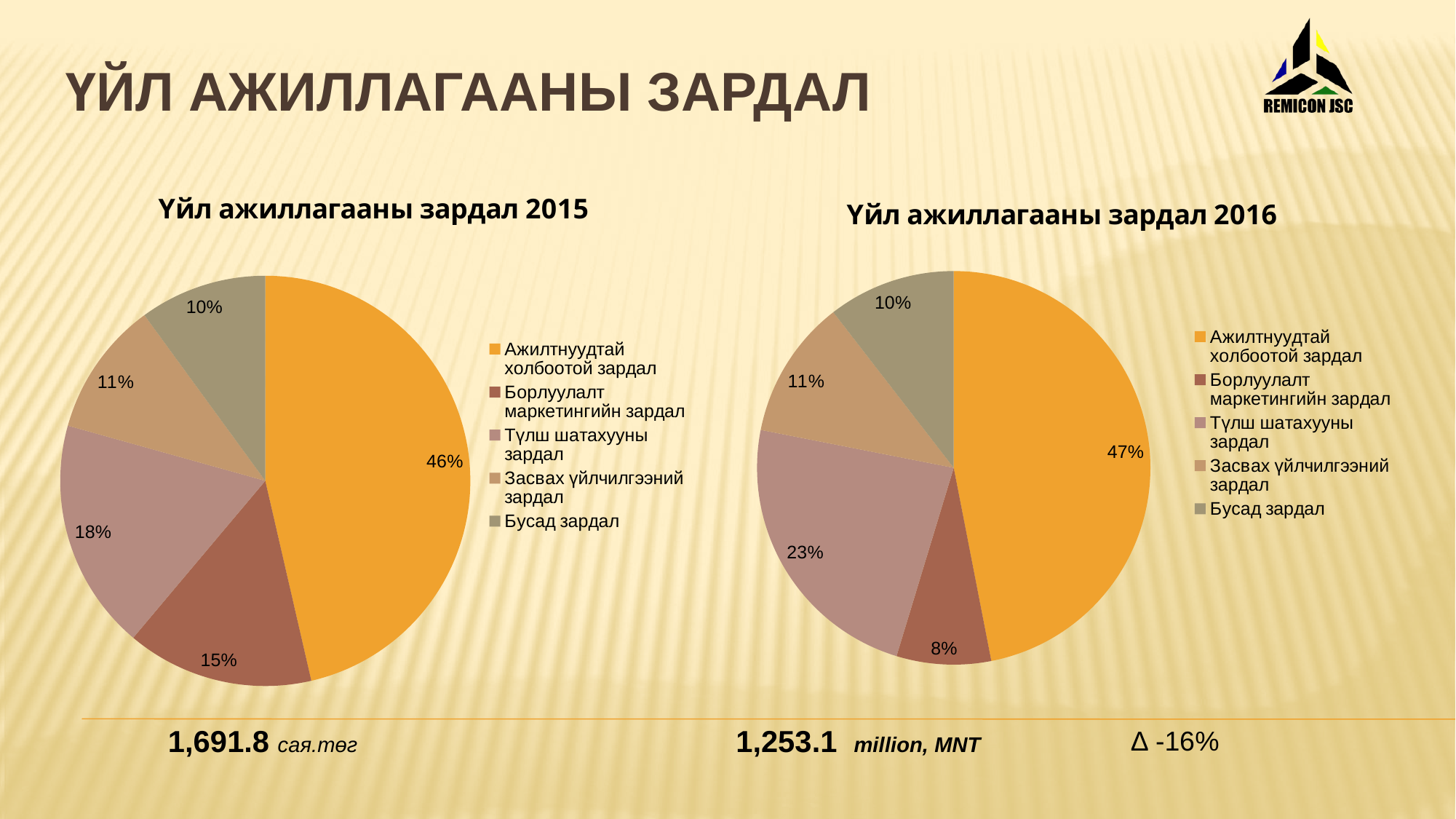
What type of chart is 'Үйл ажиллагааны зардал 2016'? Pie chart In the 'Үйл ажиллагааны зардал 2016' chart, what is the value for 'Борлуулалт маркетингийн зардал'? 8% In the 'Үйл ажиллагааны зардал 2016' chart, which category has the smallest slice? Борлуулалт маркетингийн зардал In the 'Үйл ажиллагааны зардал 2016' chart, which category has the largest slice? Ажилтнуудтай холбоотой зардал In the 'Үйл ажиллагааны зардал 2016' chart, what share does 'Түлш шатахууны зардал' have? 23% In the 'Үйл ажиллагааны зардал 2015' chart, what is the difference between 'Түлш шатахууны зардал' and 'Борлуулалт маркетингийн зардал'? 3% How many categories does the 'Үйл ажиллагааны зардал 2015' chart show? 5 In the 'Үйл ажиллагааны зардал 2015' chart, what colour is the 'Бусад зардал' slice? Grey In the 'Үйл ажиллагааны зардал 2015' chart, what is the value for 'Борлуулалт маркетингийн зардал'? 15% In the 'Үйл ажиллагааны зардал 2015' chart, which category has the smallest slice? Бусад зардал In the 'Үйл ажиллагааны зардал 2016' chart, which is larger: 'Түлш шатахууны зардал' or 'Засвах үйлчилгээний зардал'? Түлш шатахууны зардал In the 'Үйл ажиллагааны зардал 2015' chart, what share does 'Ажилтнуудтай холбоотой зардал' have? 46%